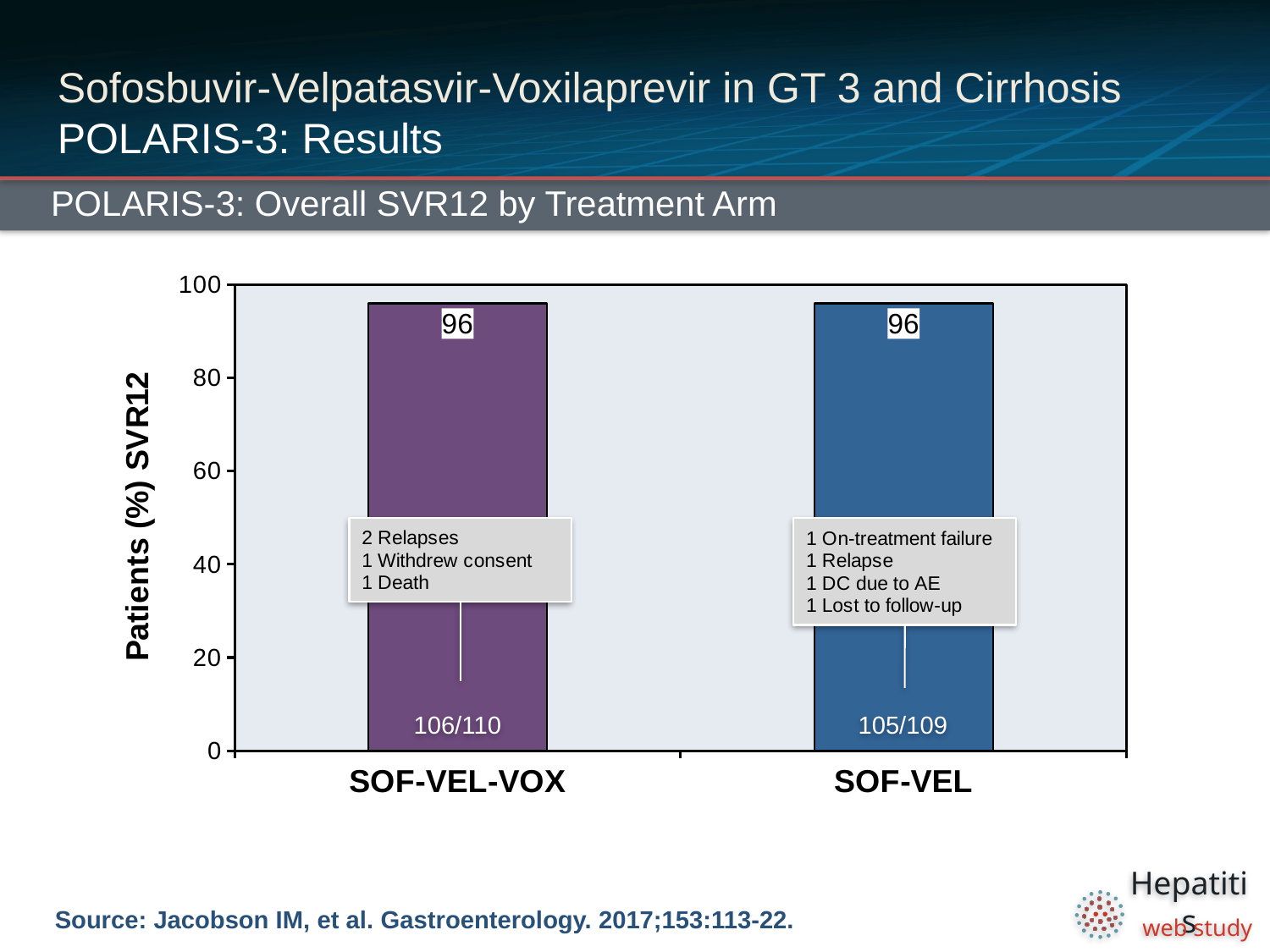
How many relapses are listed in the callout for the SOF-VEL-VOX arm? 2 What is the SVR12 value for the SOF-VEL arm? 96 What is the SVR12 value for the SOF-VEL-VOX arm? 96 What fraction of patients is shown inside the SOF-VEL bar? 105/109 What fraction of patients is shown inside the SOF-VEL-VOX bar? 106/110 What is the label of the y axis? Patients (%) SVR12 What is the title of the chart? POLARIS-3: Overall SVR12 by Treatment Arm What kind of chart is shown on the slide? bar chart How many treatment arms are shown on the x axis? 2 Is the SVR12 value for SOF-VEL greater or less than 100? less What is the difference between the SVR12 values for SOF-VEL-VOX and SOF-VEL? 0 Is the SVR12 value for SOF-VEL-VOX greater or less than 80? greater